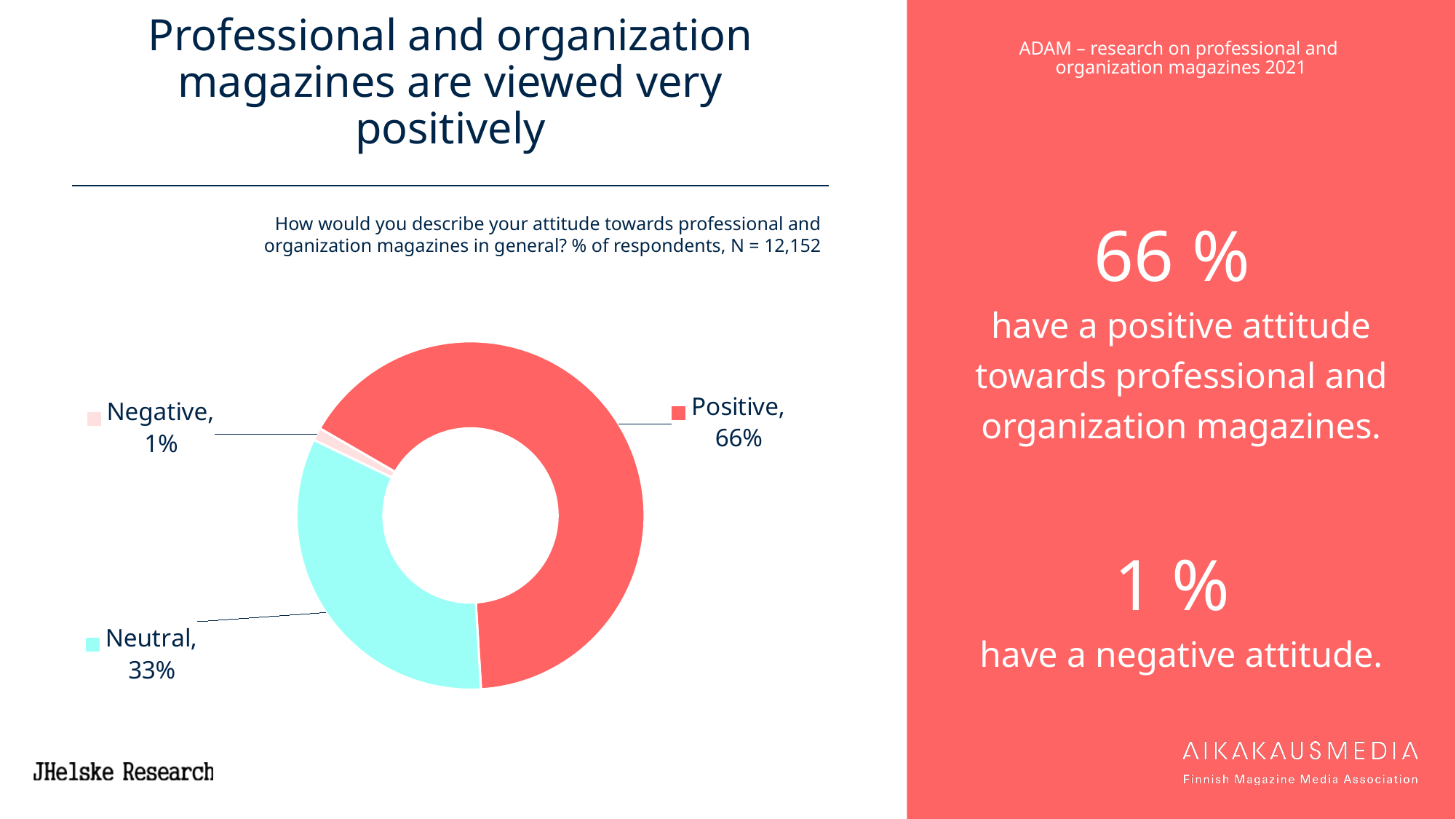
What percentage of respondents have a negative attitude? 1% What is the difference in percentage points between the Neutral and Negative shares? 32 What percentage of respondents have a neutral attitude? 33% Which attitude category has the smallest share of respondents? Negative What is the number of respondents (N) stated in the chart subtitle? 12,152 Which is larger, the Neutral share or the Negative share? Neutral What is the difference in percentage points between the Positive and Neutral shares? 33 What percentage of respondents have a positive attitude towards professional and organization magazines? 66% Which attitude category has the largest share of respondents? Positive What kind of chart is shown on the slide? Doughnut (pie) chart How many categories are shown in the chart? 3 What colour is the Neutral segment of the chart? Light blue (cyan)